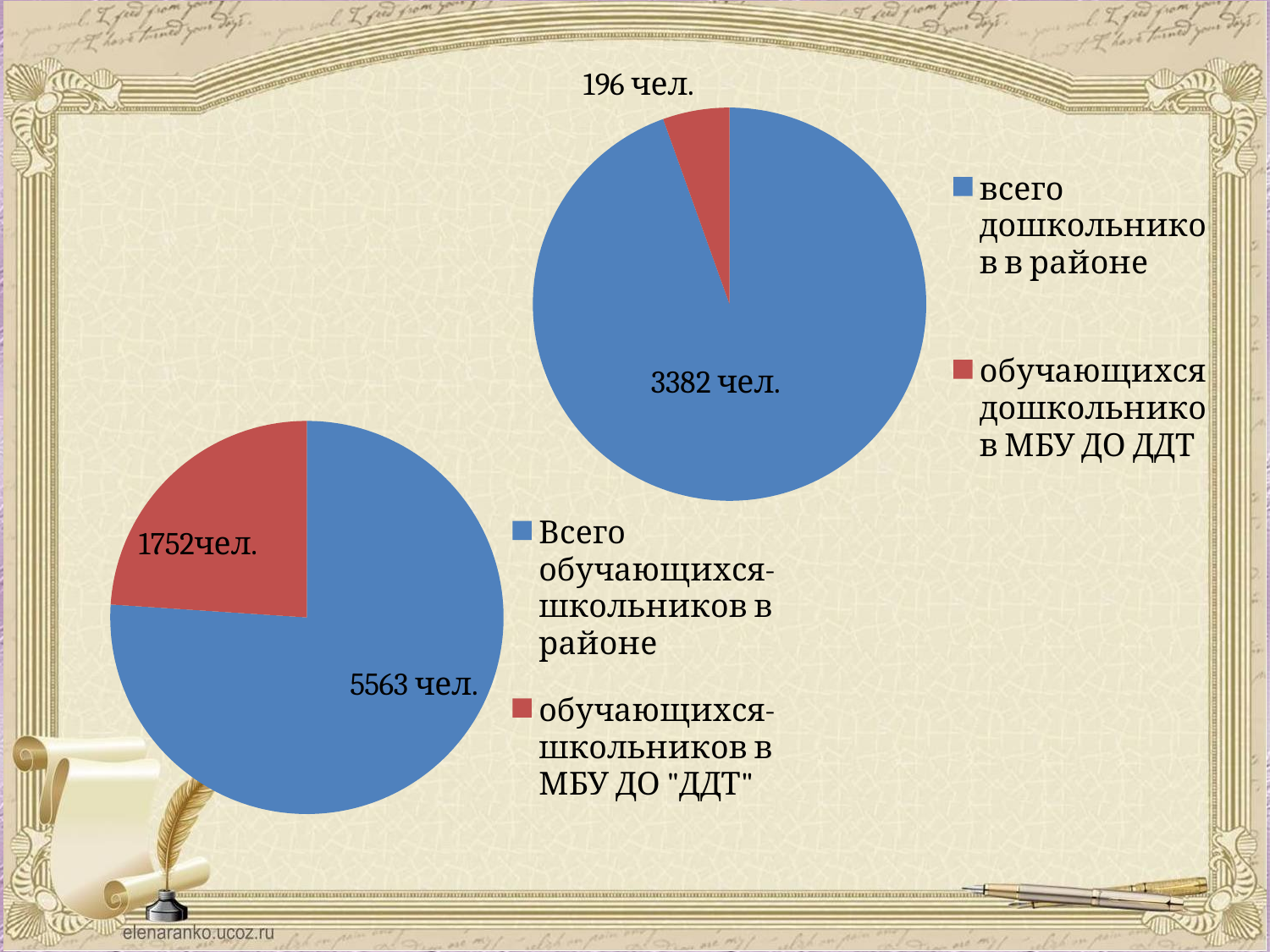
In the bottom-left pie chart, which category has the smallest slice? обучающихся-школьников в МБУ ДО "ДДТ" In the top-right pie chart, what is the value for "обучающихся дошкольников в МБУ ДО ДДТ"? 196 чел. What type of chart is the top-right chart? pie chart In the top-right pie chart, what is the value for "всего дошкольников в районе"? 3382 чел. In the top-right pie chart, which category has the largest slice? всего дошкольников в районе In the bottom-left pie chart, what is the value for "Всего обучающихся-школьников в районе"? 5563 чел. In the bottom-left pie chart, what is the difference between the two values shown? 3811 How many slices does the bottom-left pie chart have? 2 In the top-right pie chart, what colour is the slice for "обучающихся дошкольников в МБУ ДО ДДТ"? red In the bottom-left pie chart, what is the value for "обучающихся-школьников в МБУ ДО "ДДТ""? 1752чел. Which is larger: the value for "обучающихся-школьников в МБУ ДО "ДДТ"" in the bottom-left chart or the value for "обучающихся дошкольников в МБУ ДО ДДТ" in the top-right chart? обучающихся-школьников в МБУ ДО "ДДТ" In the top-right pie chart, what is the difference between the two values shown? 3186